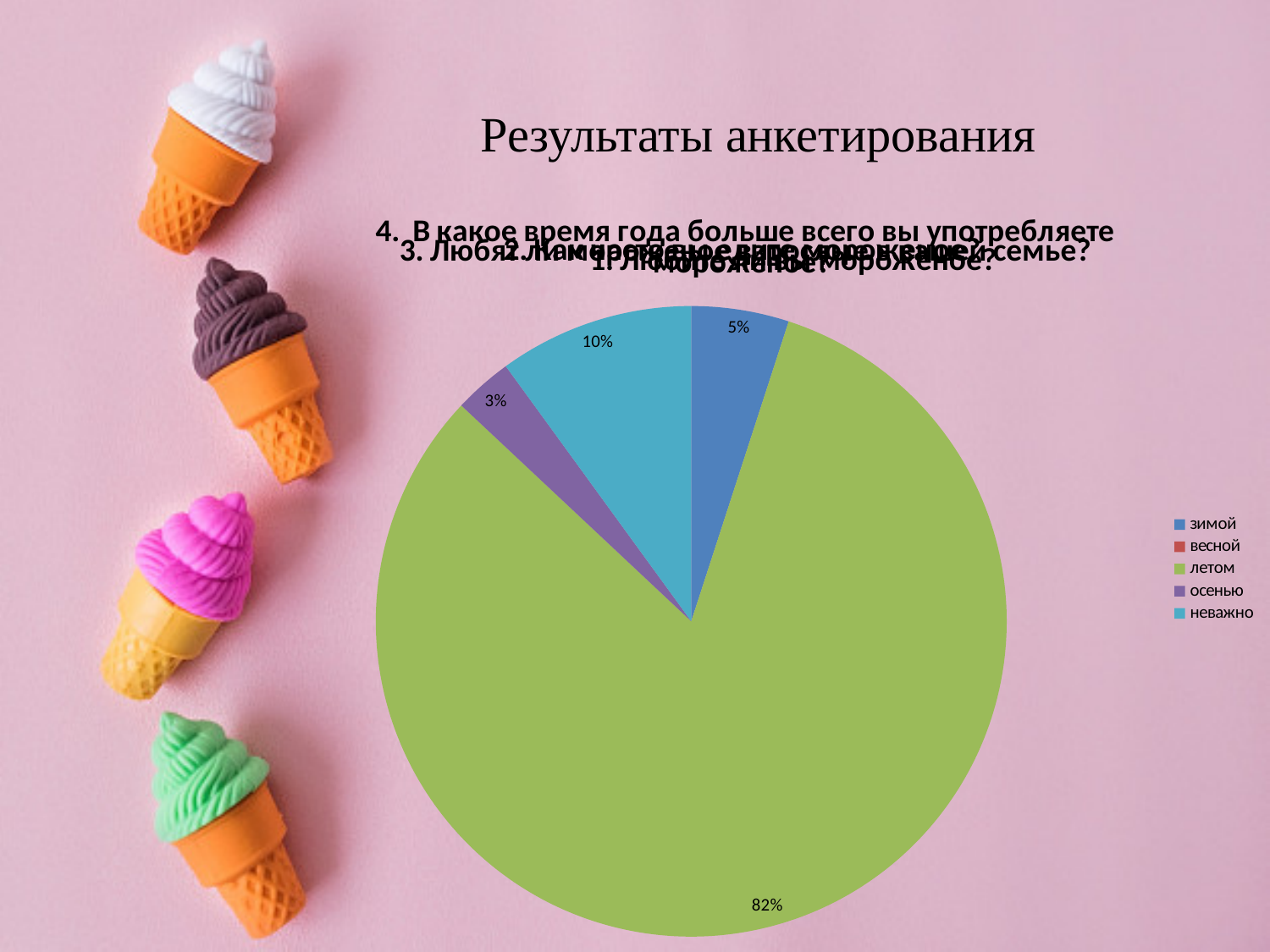
What kind of chart is shown on the slide? pie chart What percentage is shown for the "неважно" slice? 10% What percentage is shown for the "зимой" slice? 5% Which category has the largest slice of the pie chart? летом What colour is the "летом" slice? green What percentage is shown for the "осенью" slice? 3% Which slice is larger, "зимой" or "неважно"? неважно Which of the labelled slices is the smallest? осенью By how many percentage points does "летом" exceed "неважно"? 72% By how many percentage points does "зимой" exceed "осенью"? 2% What percentage of the pie chart is labelled for "летом"? 82% How many entries does the legend list? 5